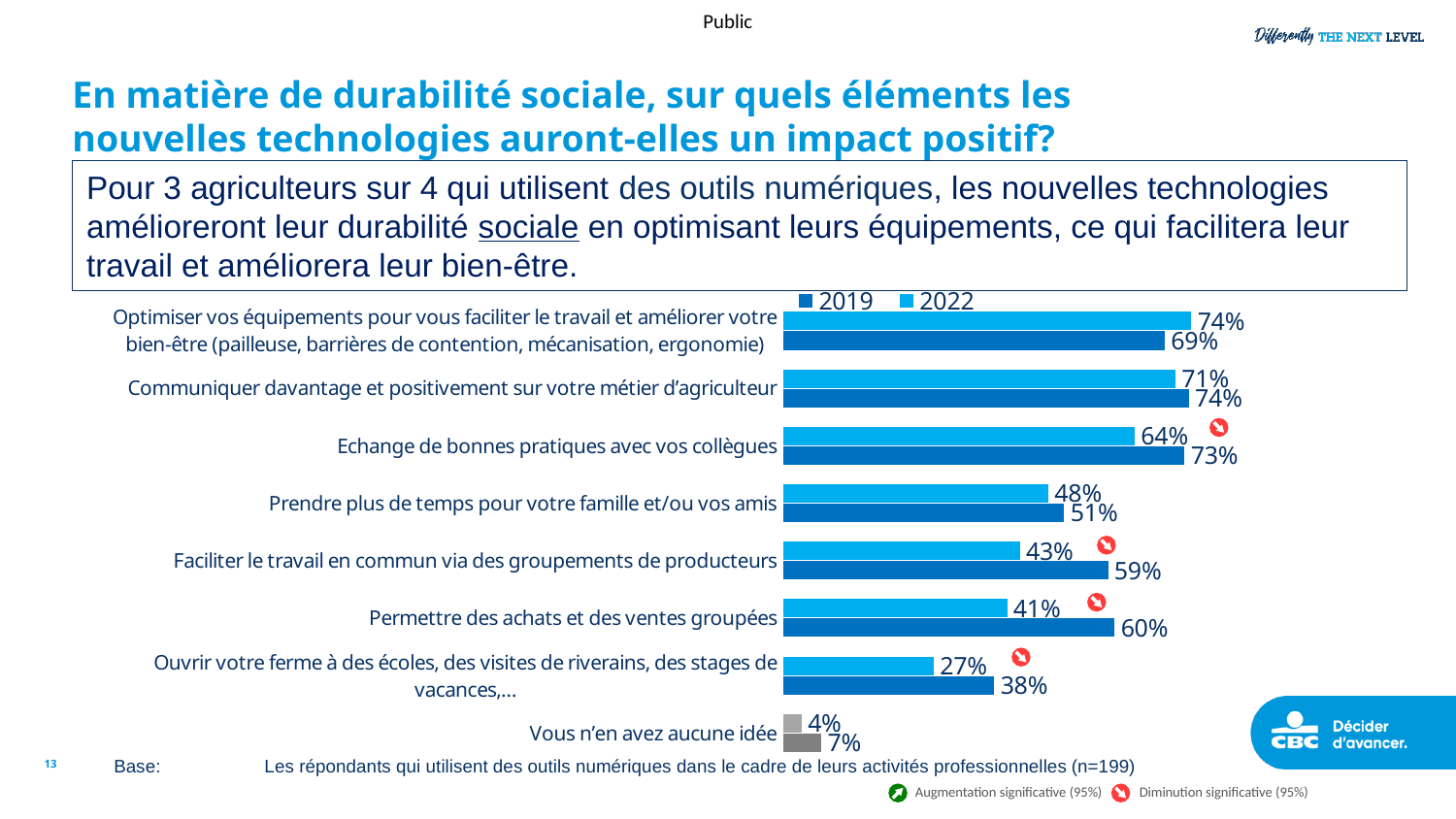
What kind of chart is shown on the slide? bar chart Which category has the highest 2022 value? Optimiser vos équipements pour vous faciliter le travail et améliorer votre bien-être Which series is shown in the legend first, 2019 or 2022? 2019 What is the 2019 value for 'Ouvrir votre ferme à des écoles, des visites de riverains, des stages de vacances,...'? 38% How many series does the chart legend list? 2 How many categories are shown in the chart? 8 What is the 2019 value for 'Echange de bonnes pratiques avec vos collègues'? 73% What is the 2022 value for 'Permettre des achats et des ventes groupées'? 41% What is the 2022 value for 'Optimiser vos équipements pour vous faciliter le travail et améliorer votre bien-être'? 74% For 'Faciliter le travail en commun via des groupements de producteurs', which year has the larger value, 2019 or 2022? 2019 Which category has the lowest 2019 value? Vous n'en avez aucune idée What is the difference between the 2019 and 2022 values for 'Permettre des achats et des ventes groupées'? 19%